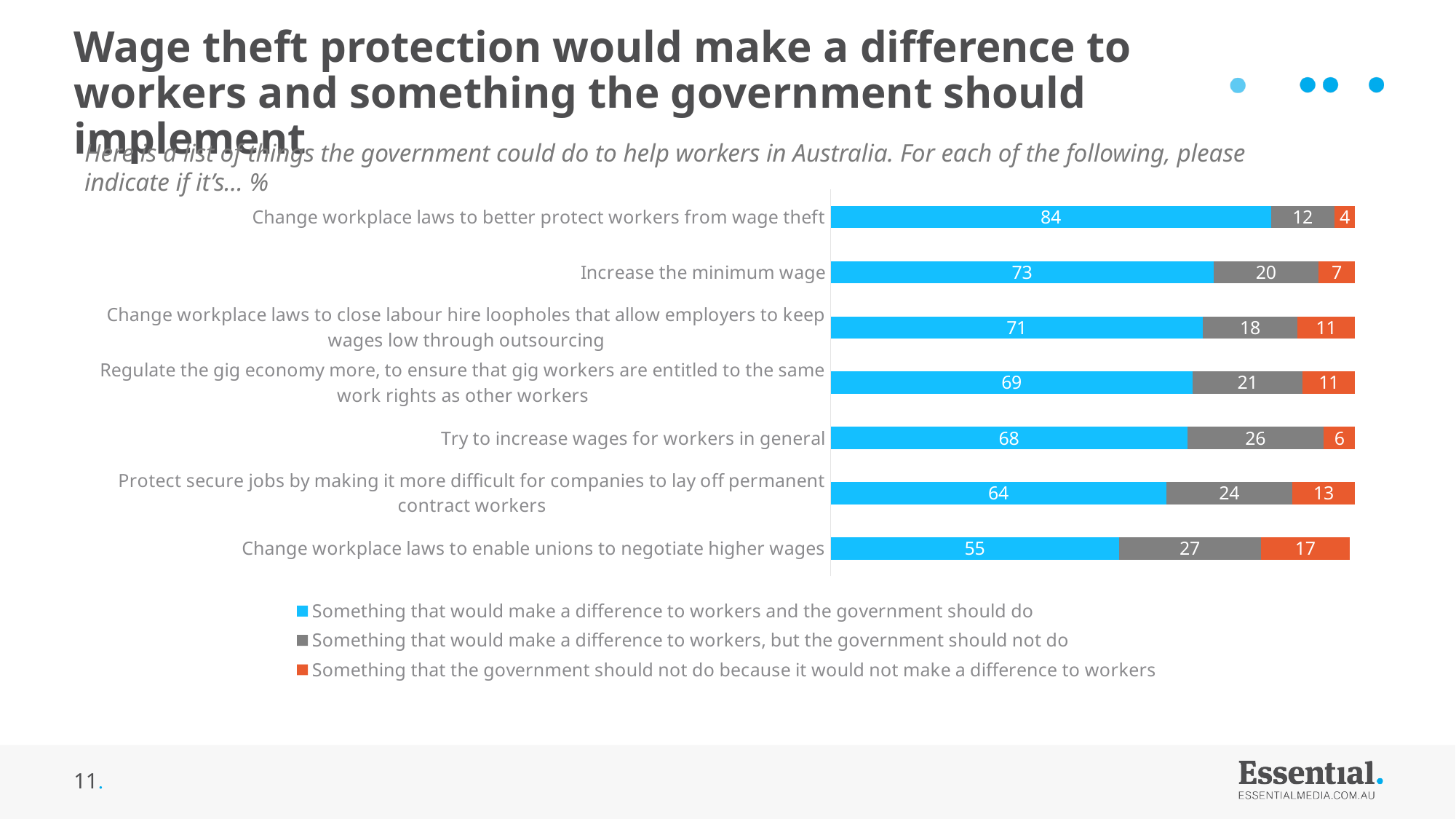
Which item has the highest share saying it would make a difference to workers and the government should do it? Change workplace laws to better protect workers from wage theft What percentage say 'Change workplace laws to better protect workers from wage theft' is something that would make a difference to workers and the government should do? 84 What percentage say 'Change workplace laws to enable unions to negotiate higher wages' is something the government should not do because it would not make a difference to workers? 17 What kind of chart is shown on the slide? Stacked bar chart How many series does the legend list? 3 What percentage say 'Increase the minimum wage' is something that would make a difference to workers, but the government should not do? 20 Which colour represents 'Something that the government should not do because it would not make a difference to workers'? Orange What is the total of the three segments for 'Regulate the gig economy more, to ensure that gig workers are entitled to the same work rights as other workers'? 101 Which has a larger 'government should not do because it would not make a difference' share: 'Try to increase wages for workers in general' or 'Protect secure jobs by making it more difficult for companies to lay off permanent contract workers'? Protect secure jobs by making it more difficult for companies to lay off permanent contract workers What is the difference between the 'should do' percentages for 'Change workplace laws to better protect workers from wage theft' and 'Increase the minimum wage'? 11 Which item has the lowest share saying it would make a difference to workers and the government should do it? Change workplace laws to enable unions to negotiate higher wages How many items (categories) are shown in the chart? 7